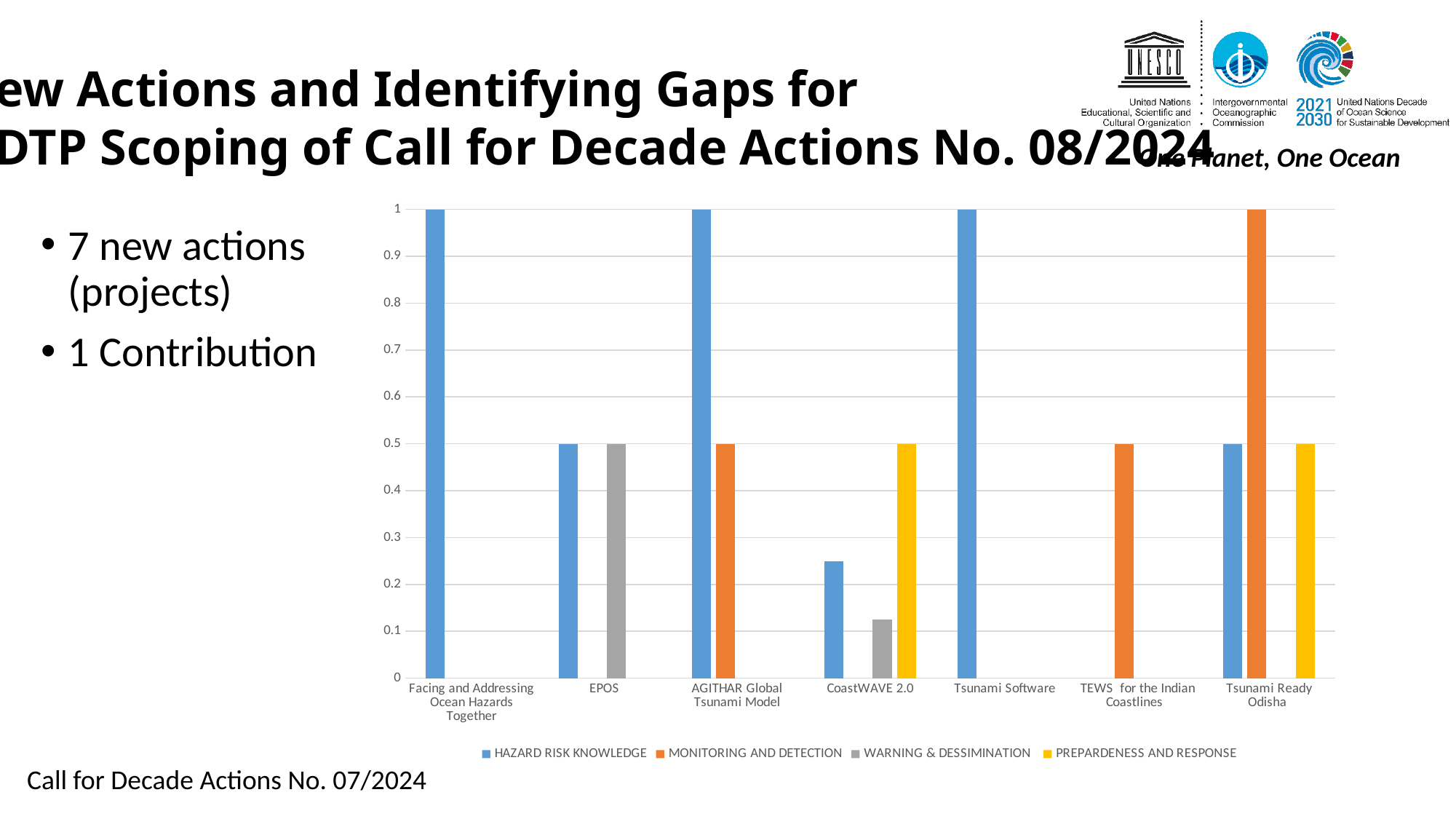
How many series does the chart's legend list? 4 What is the difference between the HAZARD RISK KNOWLEDGE value for Facing and Addressing Ocean Hazards Together and the HAZARD RISK KNOWLEDGE value for Tsunami Ready Odisha? 0.5 What kind of chart is shown on the slide? bar chart Which series in the legend is shown in orange? MONITORING AND DETECTION What is the WARNING & DESSIMINATION value for EPOS? 0.5 What is the MONITORING AND DETECTION value for TEWS for the Indian Coastlines? 0.5 What is the HAZARD RISK KNOWLEDGE value for Tsunami Software? 1 How many categories are shown along the x axis of the chart? 7 Is the HAZARD RISK KNOWLEDGE value for CoastWAVE 2.0 greater or less than 0.3? less What is the MONITORING AND DETECTION value for Tsunami Ready Odisha? 1 Is the WARNING & DESSIMINATION value for CoastWAVE 2.0 greater or less than 0.2? less Which is larger: the HAZARD RISK KNOWLEDGE value for AGITHAR Global Tsunami Model or for EPOS? AGITHAR Global Tsunami Model